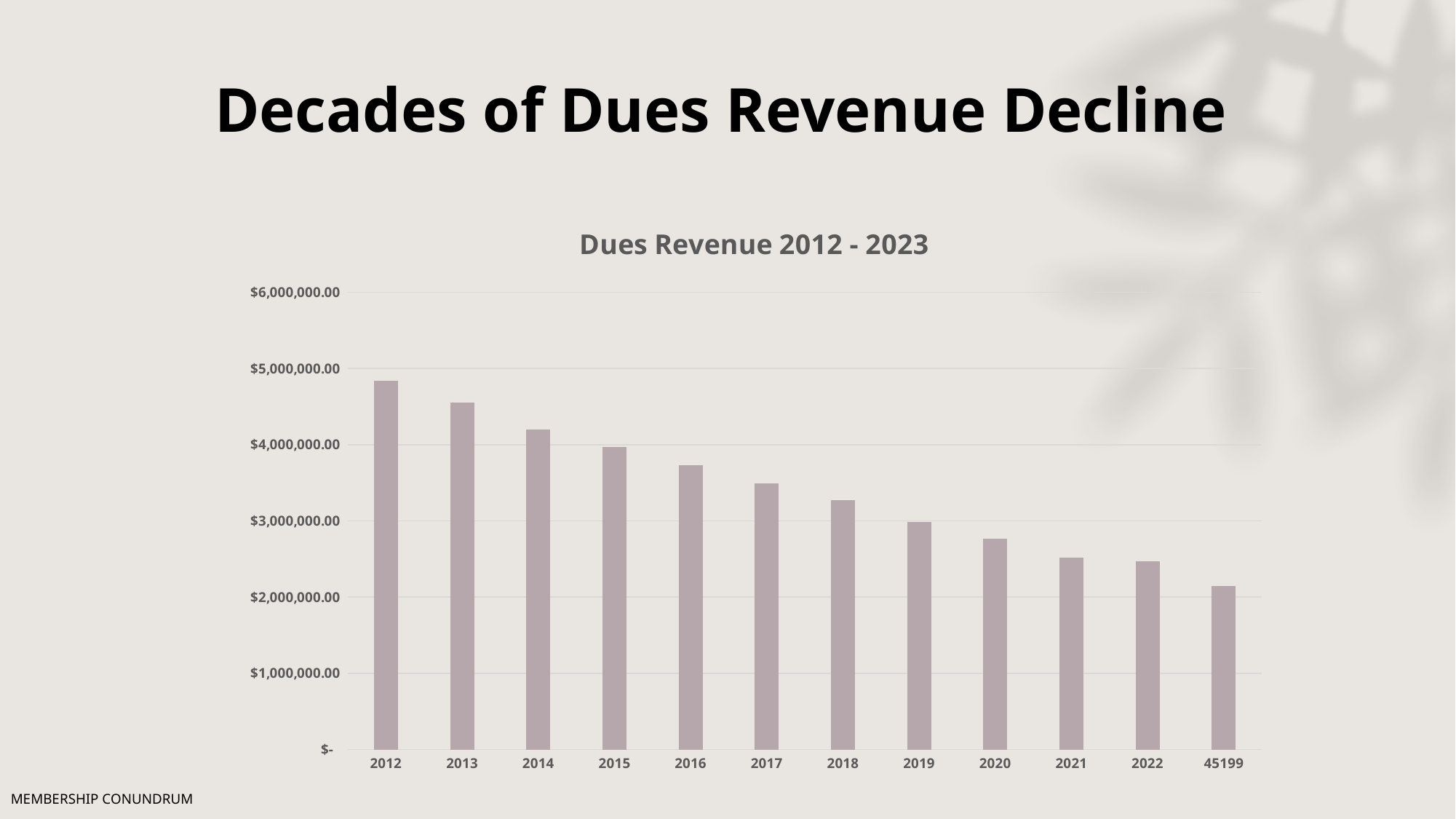
Is the value for 2017 greater or less than $4,000,000.00? less Which category has the lowest dues revenue? 45199 Is the value for 2012 greater or less than $4,000,000.00? greater Is the value for 2020 greater or less than $3,000,000.00? less How many bars (categories) are plotted in the chart? 12 Do the values rise or fall from left to right along the x axis? fall What kind of chart is shown on the slide? bar chart Which is larger, the value for 2014 or the value for 2018? 2014 What is the title of the chart? Dues Revenue 2012 - 2023 Which category has the highest dues revenue? 2012